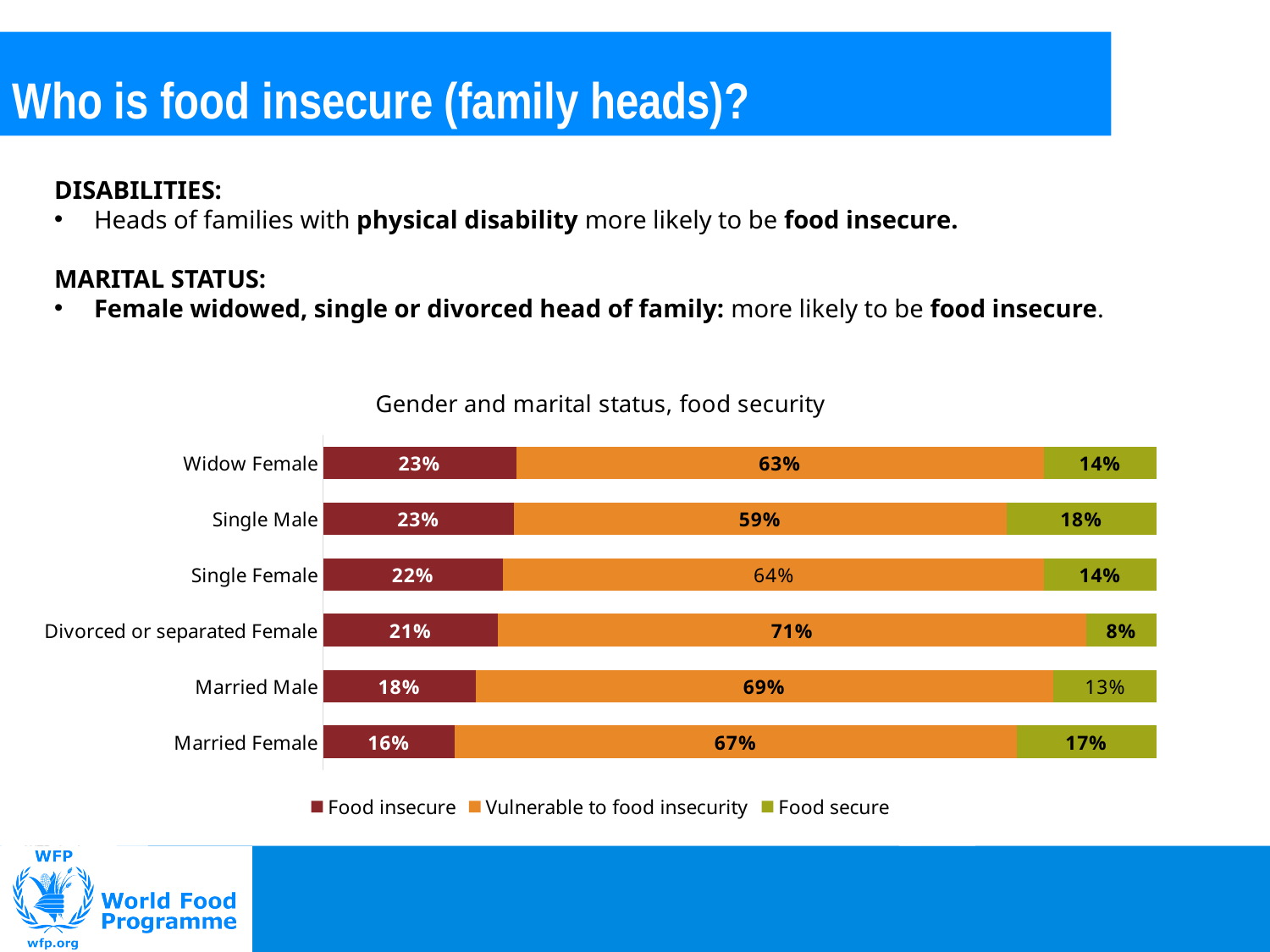
Which category has the lowest Food secure value? Divorced or separated Female Is the Food secure value larger for Single Male or Married Female? Single Male What is the Food secure value for Married Male? 13% Which category has the highest Vulnerable to food insecurity value? Divorced or separated Female How many categories are shown on the chart? 6 What is the Vulnerable to food insecurity value for Divorced or separated Female? 71% What is the Food insecure value for Widow Female? 23% What kind of chart is shown? Stacked bar chart What is the difference between the Food insecure values for Widow Female and Married Female? 7% Which category has the lowest Food insecure value? Married Female How many series does the legend list? 3 What is the title of the chart? Gender and marital status, food security